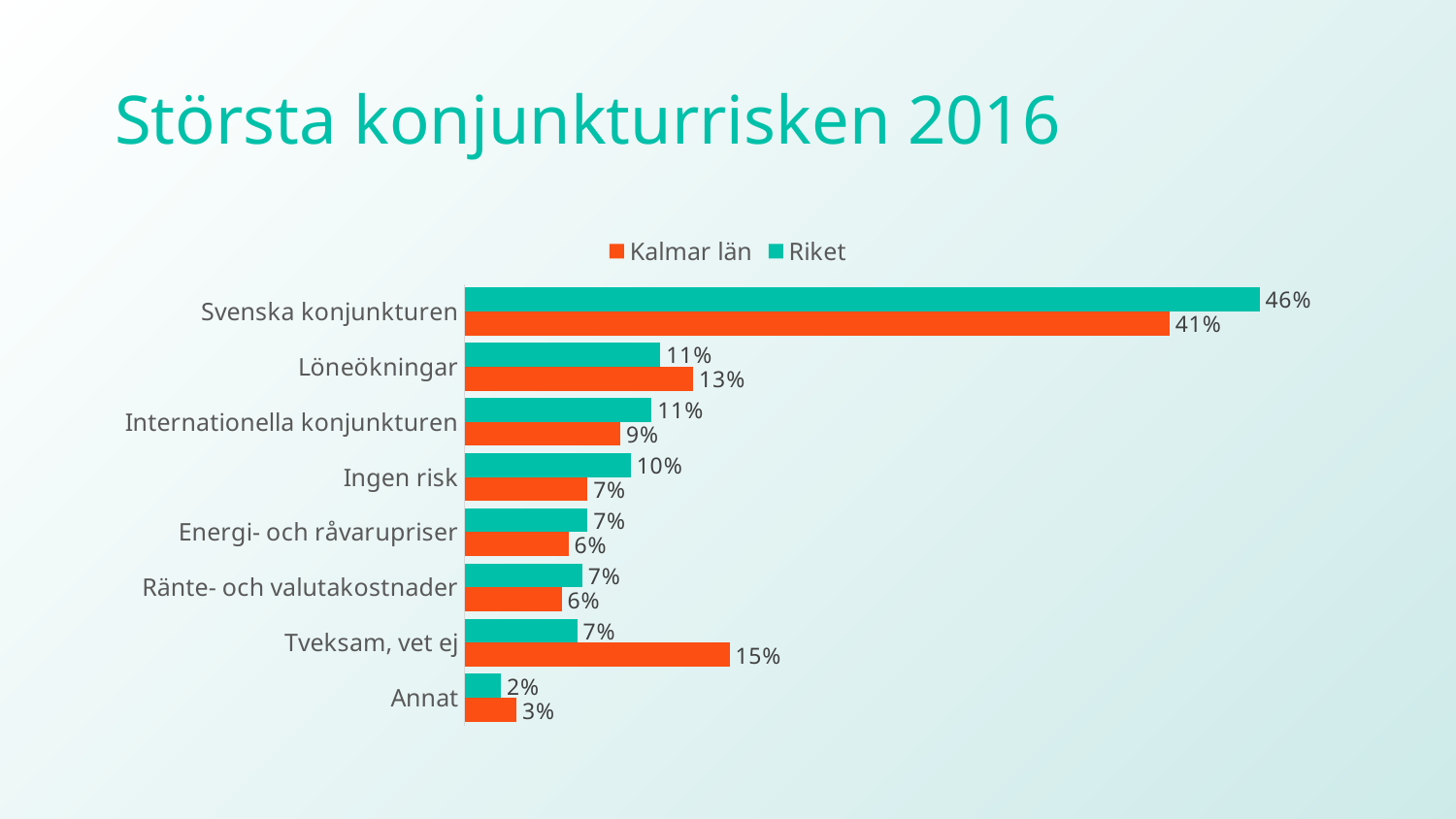
How many series does the legend list? 2 What is the value for Kalmar län for Löneökningar? 13% Which category has the lowest value for Riket? Annat What is the difference between Kalmar län and Riket for Tveksam, vet ej? 8% Which is larger for Internationella konjunkturen, Kalmar län or Riket? Riket What is the value for Riket for Ingen risk? 10% What is the difference between Riket and Kalmar län for Svenska konjunkturen? 5% Which category has the highest value for Kalmar län? Svenska konjunkturen What kind of chart is shown on the slide? Bar chart What is the value for Kalmar län for Tveksam, vet ej? 15% How many categories are shown in the chart? 8 What is the value for Riket for Svenska konjunkturen? 46%